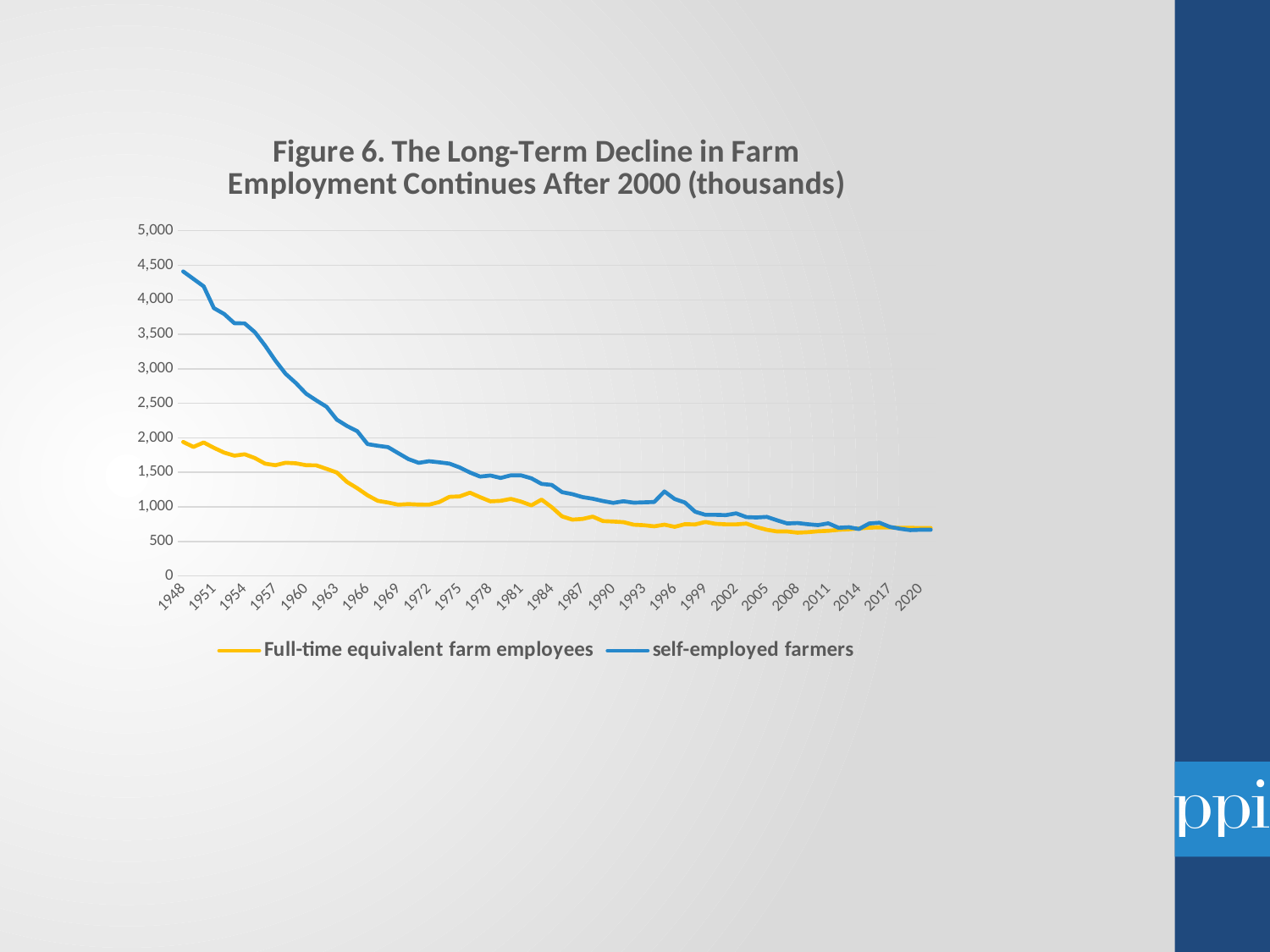
Is the value for Full-time equivalent farm employees in 2008 greater or less than 1,000? less Is the value for self-employed farmers in 1960 greater or less than 2,000? greater What kind of chart is shown on the slide? line chart Which series is drawn in blue? self-employed farmers How many series does the legend list? 2 What is the title of the chart? Figure 6. The Long-Term Decline in Farm Employment Continues After 2000 (thousands) In which year does the self-employed farmers series reach its highest value? 1948 Does the Full-time equivalent farm employees series rise or fall from 1948 to 1970? fall Does the self-employed farmers series rise or fall from 1948 to 2020? fall Is the value for Full-time equivalent farm employees in 1948 greater or less than 2,500? less In 1948, which series has the higher value: self-employed farmers or Full-time equivalent farm employees? self-employed farmers